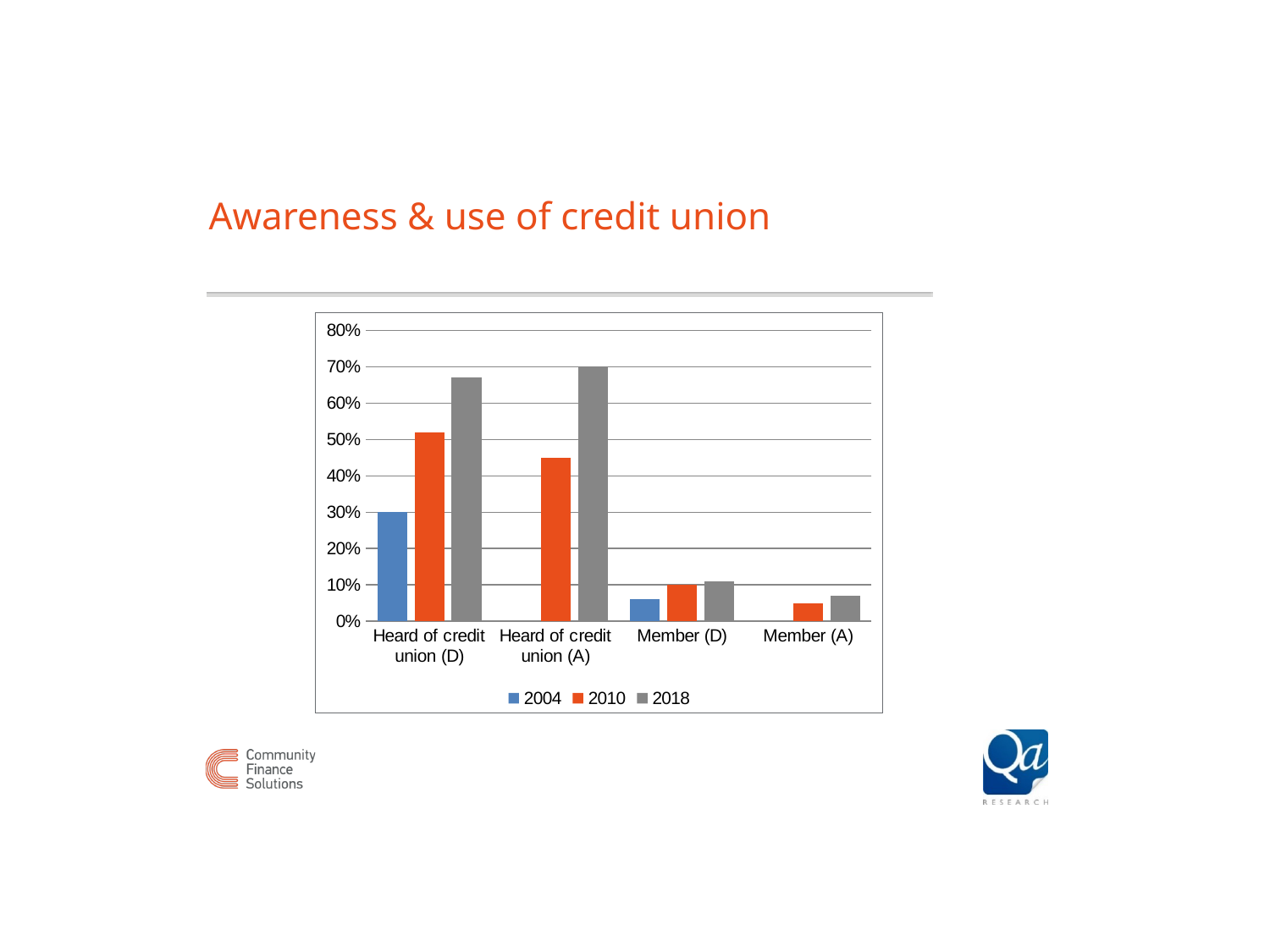
For Heard of credit union (D), do the values rise or fall from 2004 to 2018? rise For Heard of credit union (D), which year has the larger value, 2010 or 2018? 2018 Is the 2010 value for Heard of credit union (A) greater or less than 40%? greater Is the 2018 value for Heard of credit union (D) greater or less than 60%? greater What kind of chart is shown on the slide? bar chart Which category has the lowest value for 2010? Member (A) How many categories are shown on the x axis? 4 Which category has the highest value for 2018? Heard of credit union (A) Is the 2010 value for Heard of credit union (D) greater or less than 50%? greater What is the title of the slide containing the chart? Awareness & use of credit union How many series does the legend list? 3